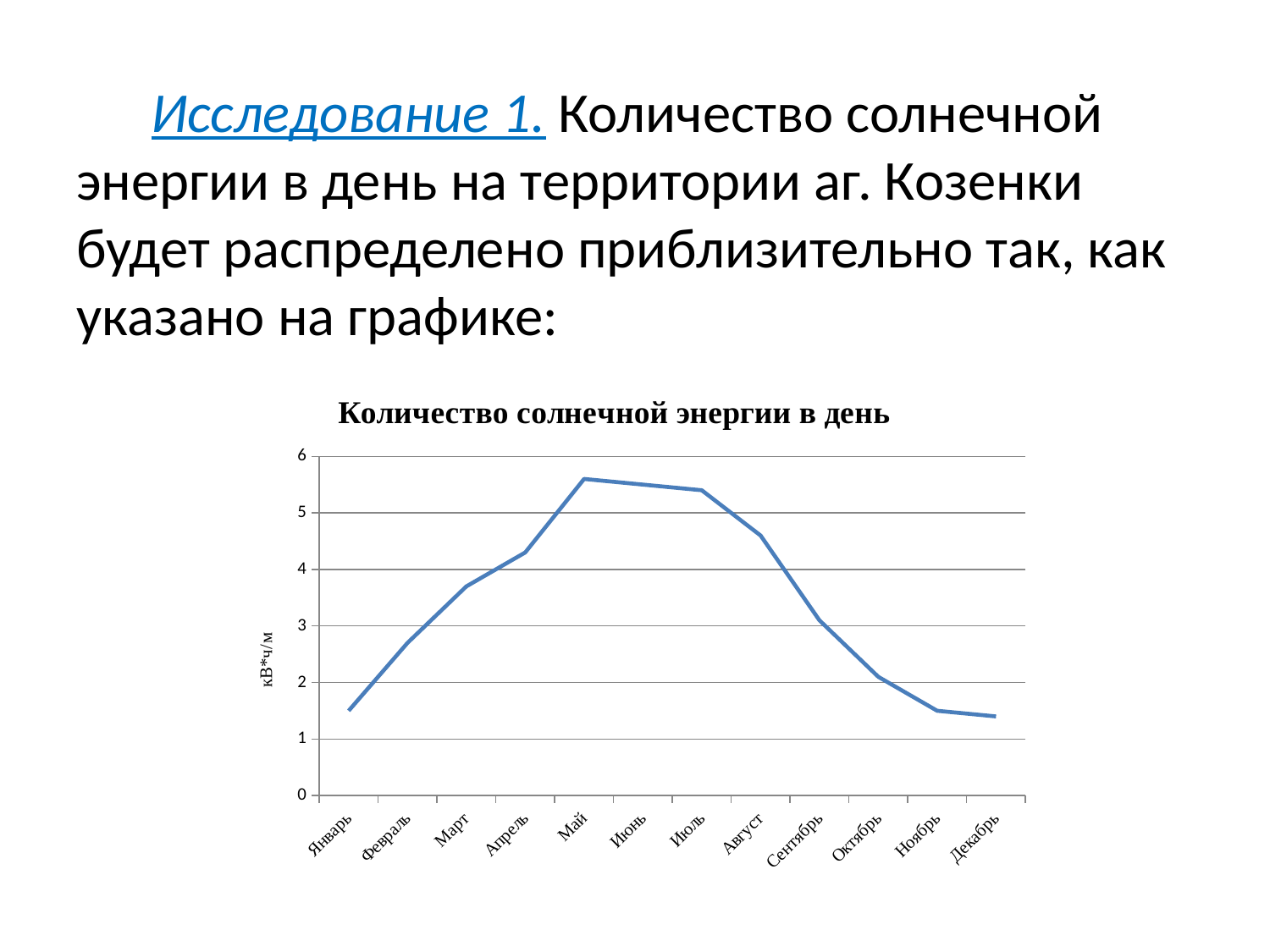
Is the value for Май greater or less than 5? greater Do the values rise or fall from Июль to Декабрь? fall What is the title of the chart? Количество солнечной энергии в день How many months are plotted on the x axis of the chart? 12 Is the value for Апрель greater or less than 4? greater Is the value for Январь greater or less than 2? less Which month has the highest value on the chart? Май Which is larger, the value for Март or the value for Сентябрь? Март Which is larger, the value for Июль or the value for Август? Июль What kind of chart is shown on the slide? line chart